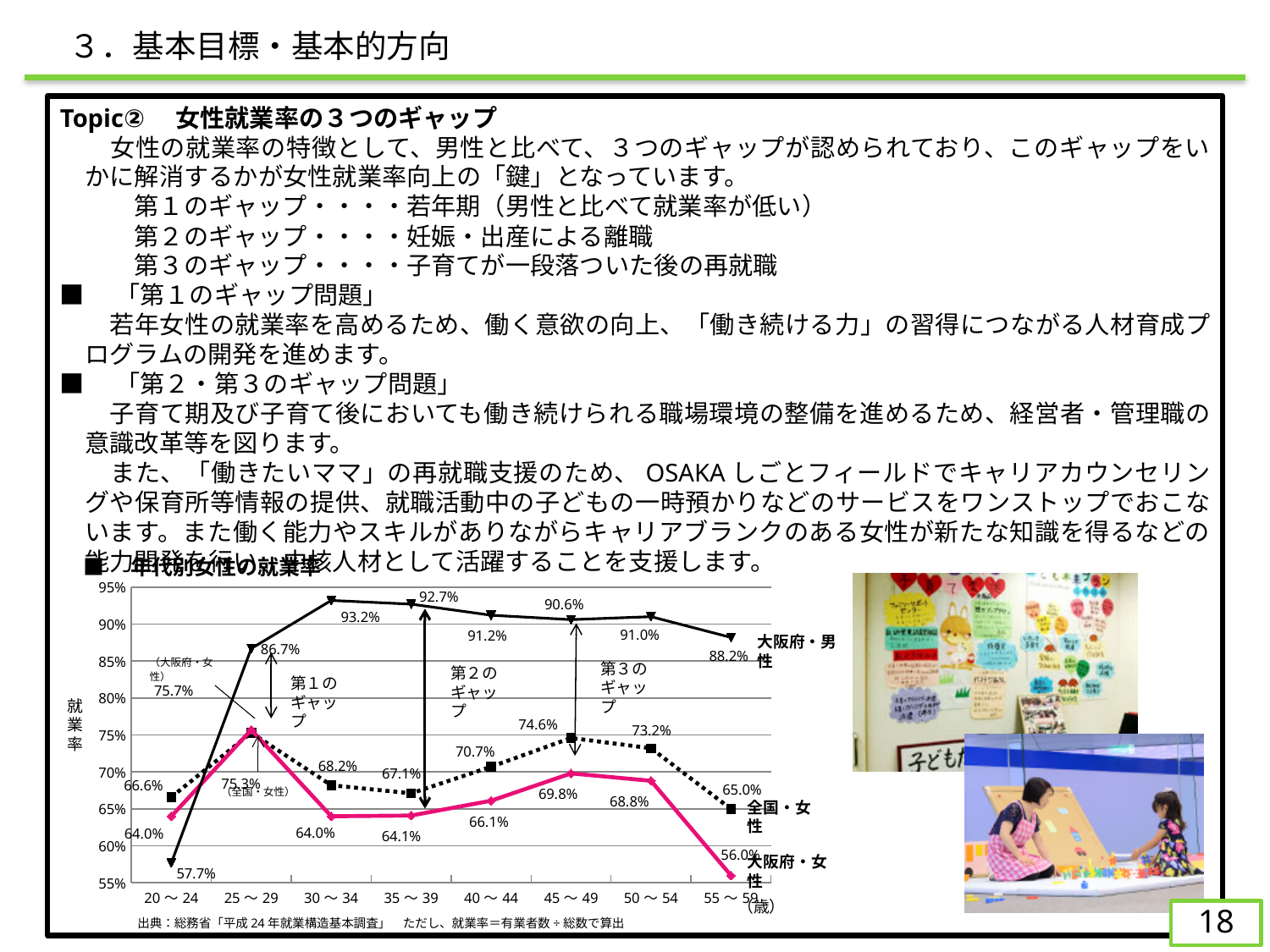
What type of chart is shown on the slide? line chart What is the employment rate for 大阪府・女性 in the 55～59 age group? 56.0% How many series does the chart show? 3 What is the difference between 大阪府・男性 and 大阪府・女性 in the 45～49 age group? 20.8% How many age groups are plotted on the x axis? 8 Which age group has the lowest employment rate for 大阪府・女性? 55～59 What is the employment rate for 全国・女性 in the 45～49 age group? 74.6% What is the employment rate for 大阪府・男性 in the 30～34 age group? 93.2% Which is larger in the 40～44 age group, 全国・女性 or 大阪府・女性? 全国・女性 What is the employment rate for 大阪府・男性 in the 20～24 age group? 57.7% Which age group has the highest employment rate for 大阪府・男性? 30～34 What is the title of the chart? 年代別女性の就業率